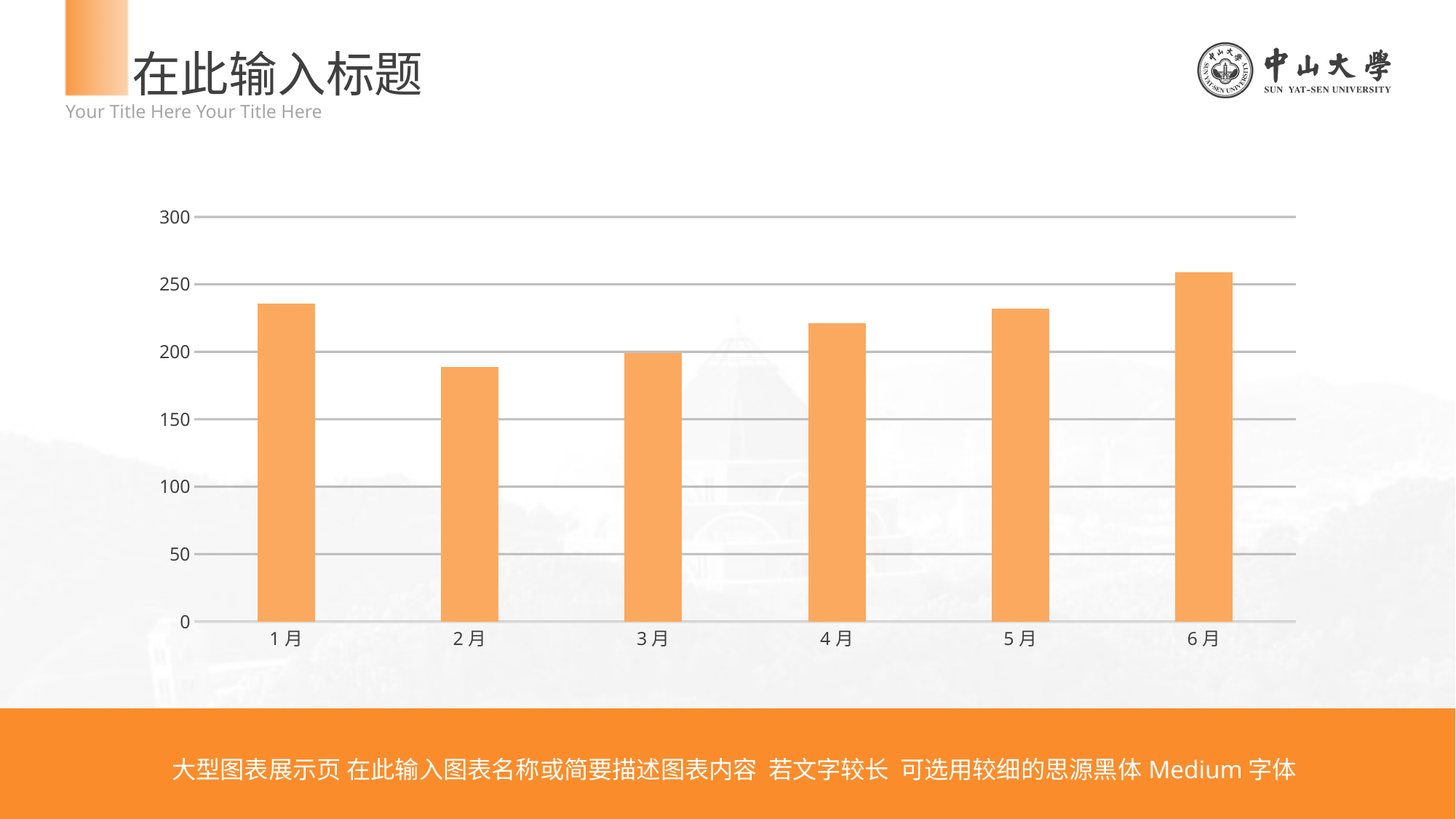
How many categories (months) are shown on the x axis of the chart? 6 Which month has the highest bar in the chart? 6月 Is the value for 2月 greater or less than 200? less Which month has the lowest bar in the chart? 2月 From 2月 to 6月, do the values rise or fall? rise What kind of chart is shown on the slide? bar chart Is the value for 4月 greater or less than 200? greater Is the value for 5月 greater or less than 250? less What colour are the bars in the chart? orange Which is larger, the value for 1月 or the value for 4月? 1月